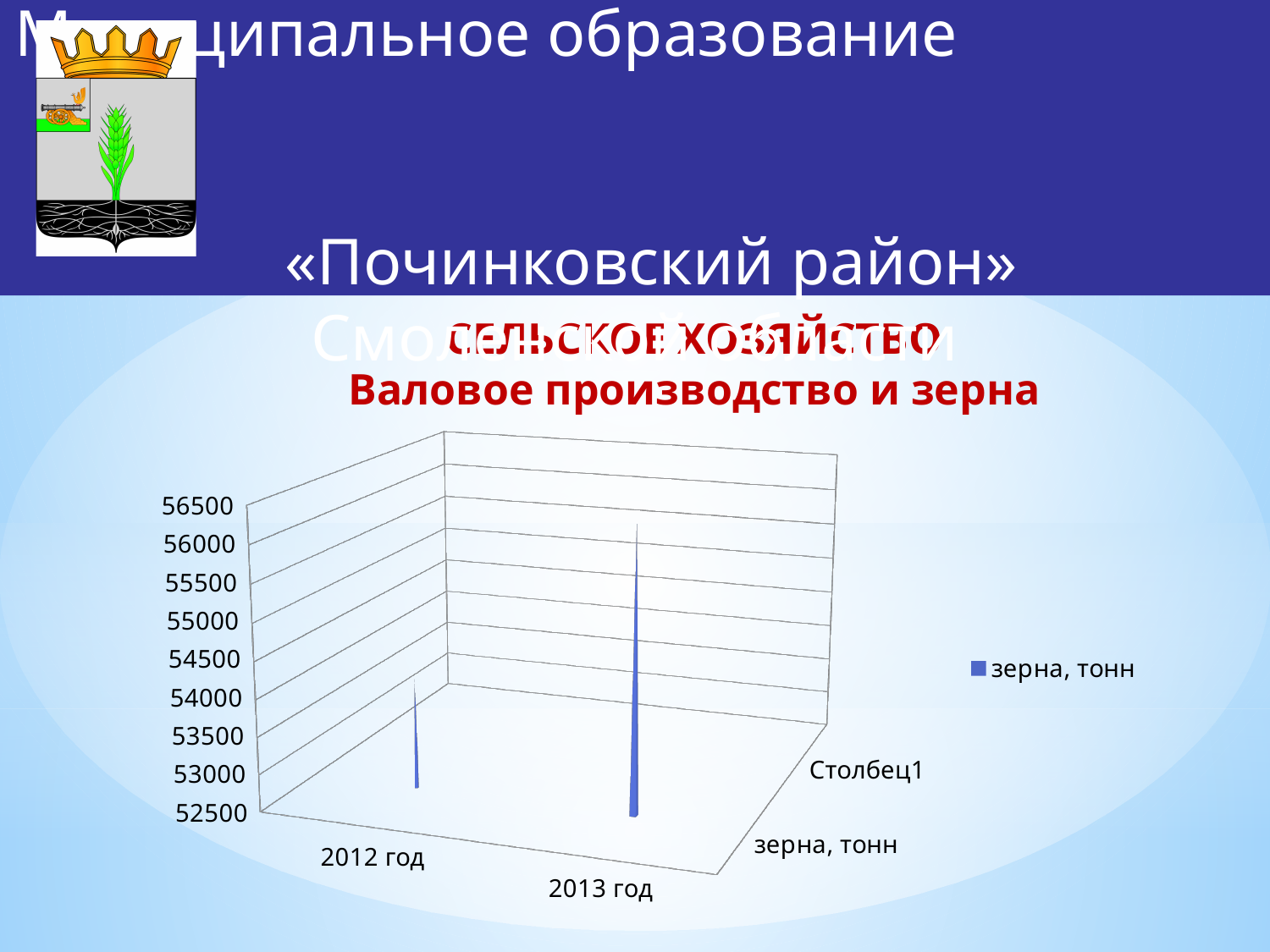
How many categories are plotted along the x axis of the chart? 2 Is the value for 2012 год greater or less than 53000? greater How many series does the chart legend list? 1 What is the title of the chart? Валовое производство и зерна Which year has the highest value for зерна, тонн? 2013 год Is the value for 2012 год greater or less than 55000? less What series name is shown in the chart legend? зерна, тонн Do the values rise or fall from 2012 год to 2013 год? rise Is the value for 2013 год greater or less than 55000? greater Which is larger, the value for 2012 год or for 2013 год? 2013 год What kind of chart is shown on the slide? bar chart Which year has the lowest value for зерна, тонн? 2012 год